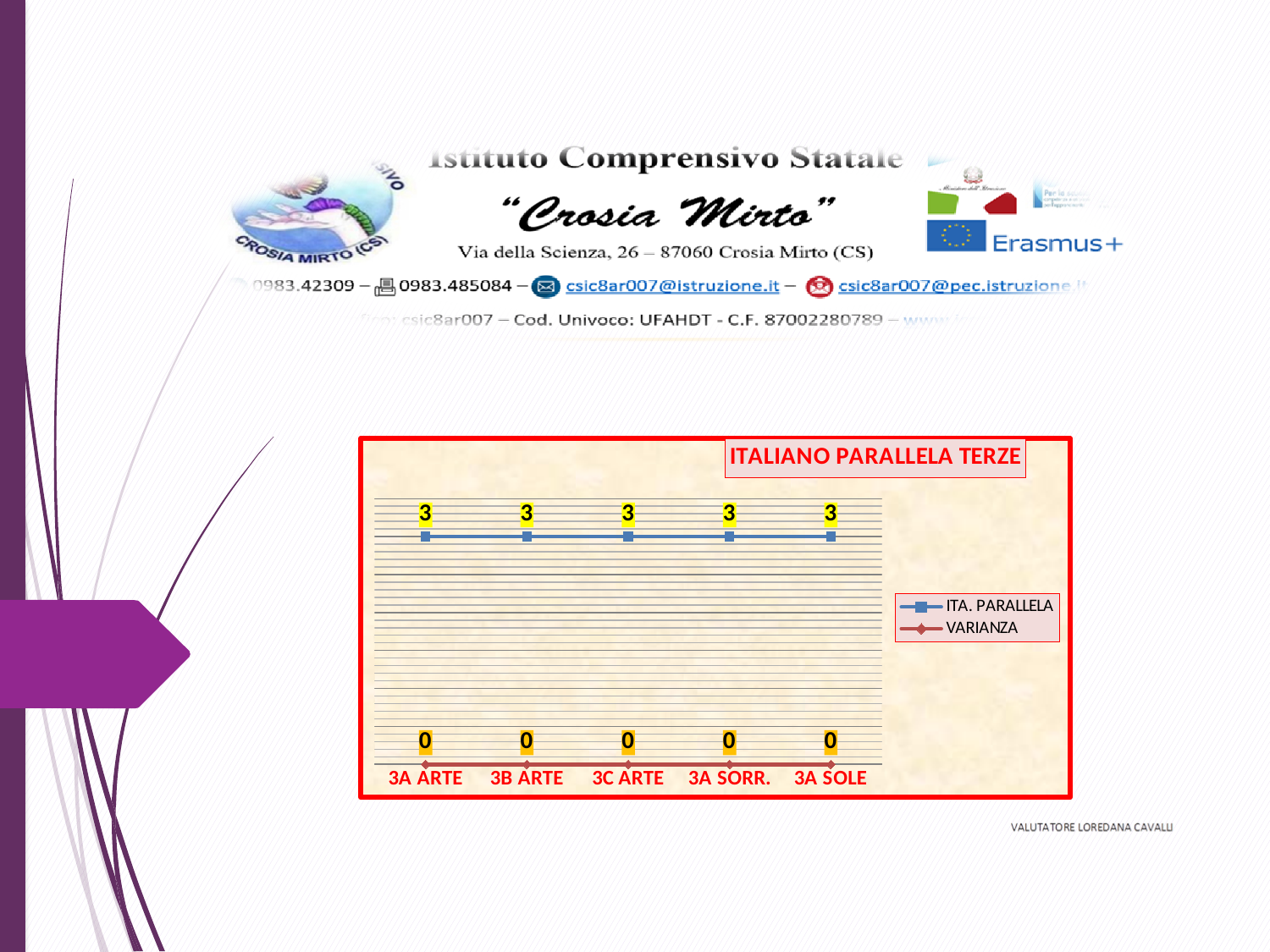
What is the value of VARIANZA for 3A SORR.? 0 What is the value of ITA. PARALLELA for 3A ARTE? 3 Which series is drawn in red in the legend? VARIANZA What is the value of ITA. PARALLELA for 3A SOLE? 3 What is the difference between ITA. PARALLELA and VARIANZA for 3B ARTE? 3 What is the value of VARIANZA for 3C ARTE? 0 Do the ITA. PARALLELA values rise, fall, or stay the same across the categories? stay the same What is the title of the chart? ITALIANO PARALLELA TERZE How many categories are shown on the x axis? 5 Which series has the larger value for 3A SORR., ITA. PARALLELA or VARIANZA? ITA. PARALLELA How many series does the legend list? 2 What kind of chart is this? line chart